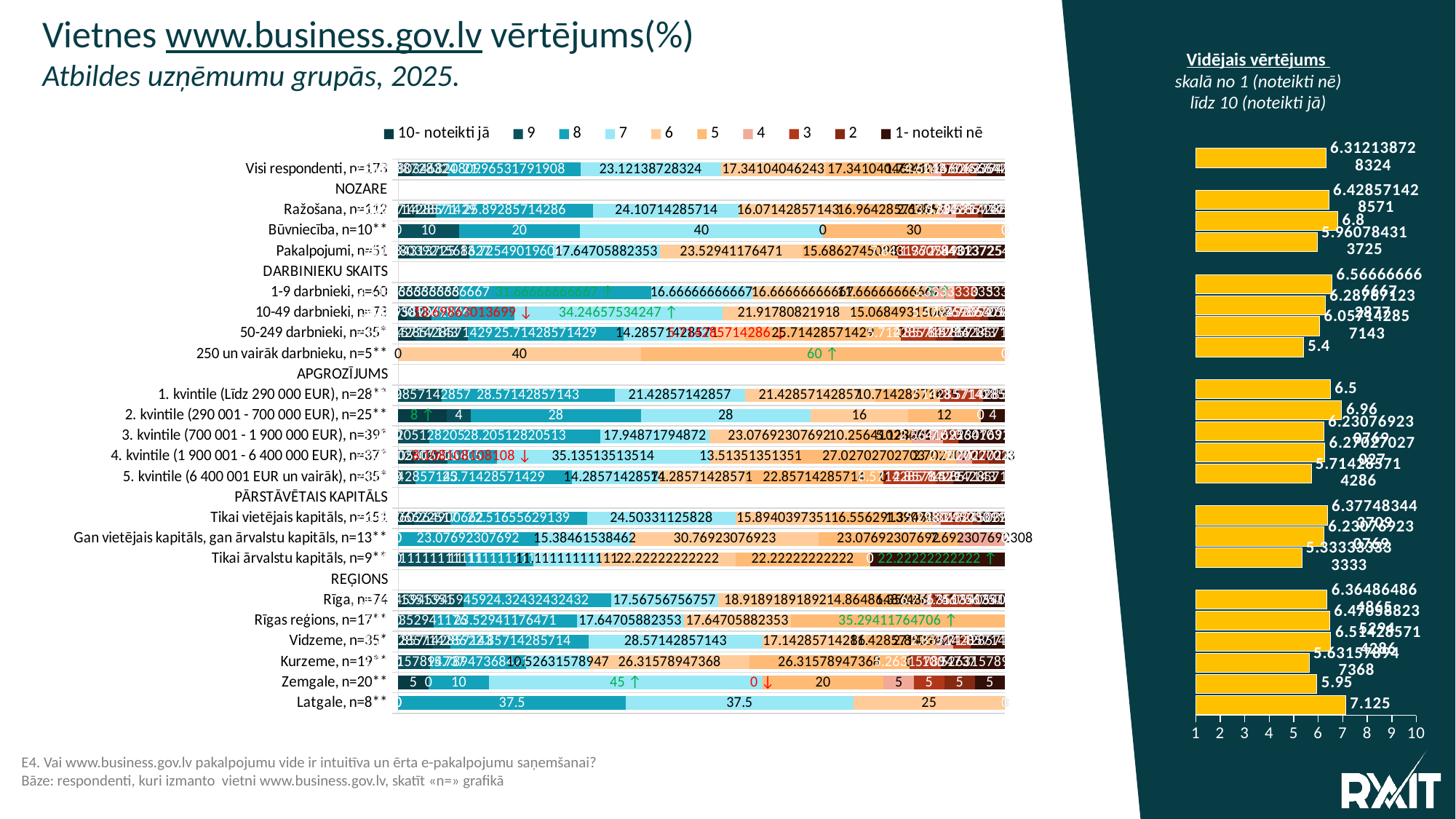
In the left-hand stacked chart, what percentage of Zemgale, n=20** respondents gave a rating of 7? 45 In the right-hand chart (Vidējais vērtējums), what is the average rating for Būvniecība, n=10**? 6.8 In the right-hand chart (Vidējais vērtējums), which has the higher average rating: Būvniecība, n=10** or 250 un vairāk darbinieku, n=5**? Būvniecība, n=10** In the right-hand chart (Vidējais vērtējums), what is the difference between the average ratings of Latgale, n=8** and Zemgale, n=20**? 1.175 How many series does the legend of the left-hand stacked chart list? 10 In the right-hand chart (Vidējais vērtējums), which group has the highest average rating? Latgale, n=8** In the left-hand stacked chart, what percentage of Latgale, n=8** respondents gave a rating of 8? 37.5 In the right-hand chart (Vidējais vērtējums), is the value for Latgale, n=8** greater or less than 7? greater In the right-hand chart (Vidējais vērtējums), which group has the lowest average rating? Tikai ārvalstu kapitāls, n=9** In the right-hand chart (Vidējais vērtējums), what is the average rating for 250 un vairāk darbinieku, n=5**? 5.4 In the right-hand chart (Vidējais vērtējums), what is the average rating for 2. kvintile (290 001 - 700 000 EUR), n=25**? 6.96 In the right-hand chart (Vidējais vērtējums), what is the average rating for Latgale, n=8**? 7.125